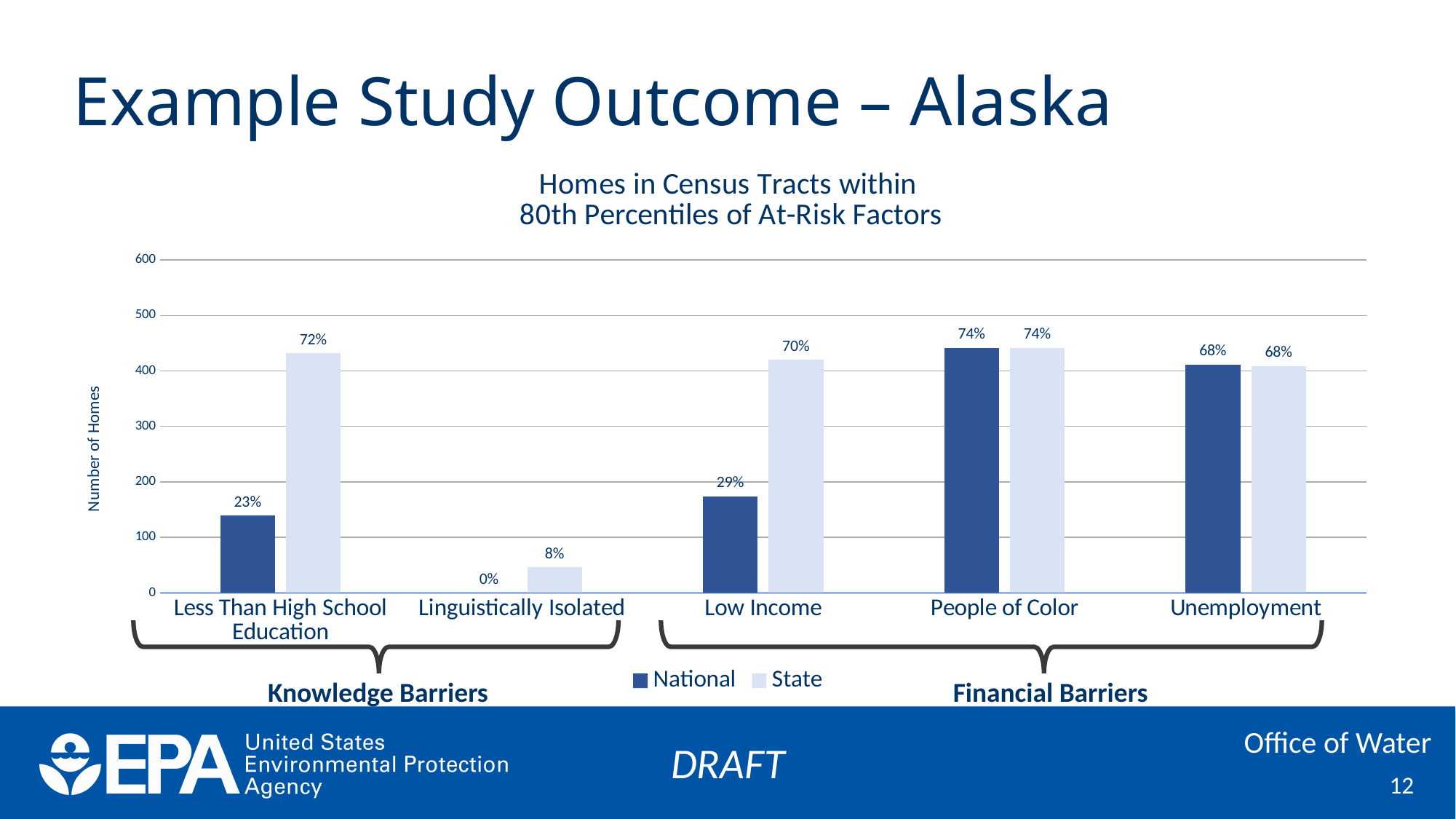
Which category has the highest State data label? People of Color What is the data label on the State bar for Unemployment? 68% What is the data label on the National bar for Linguistically Isolated? 0% What is the data label on the State bar for Less Than High School Education? 72% For Low Income, which series has the taller bar, National or State? State What is the difference in percentage points between the State and National labels for Less Than High School Education? 49 percentage points Which category has the lowest National data label? Linguistically Isolated What is the data label on the National bar for Low Income? 29% Is the State bar for Less Than High School Education greater or less than 400 homes? greater How many categories are shown on the x axis? 5 How many series does the legend list? 2 Is the National bar for Low Income greater or less than 200 homes? less